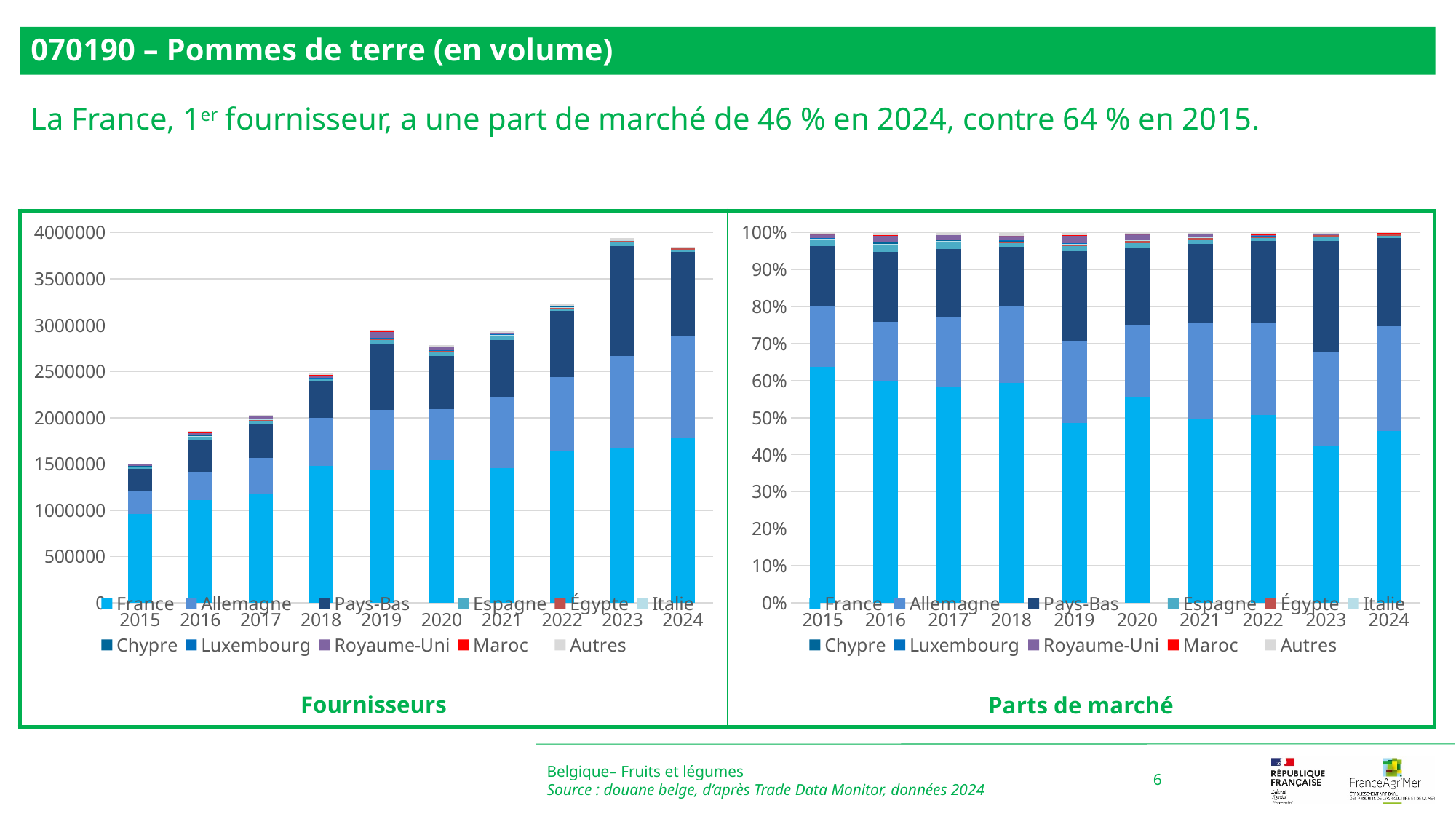
In the 'Fournisseurs' chart, is the total for 2024 greater or less than 3500000? greater In the 'Parts de marché' chart, is the share for France in 2024 greater or less than 50%? less In the 'Fournisseurs' chart, which year has the lowest total bar? 2015 How many series does the legend of the 'Fournisseurs' chart list? 11 In the 'Parts de marché' chart, is the share for France in 2015 greater or less than 60%? greater What kind of chart is the 'Fournisseurs' chart on the left? stacked bar chart In the 'Fournisseurs' chart, which year has the highest total bar? 2023 What is the title of the chart on the right of the slide? Parts de marché In the 'Fournisseurs' chart, do the total bars generally rise or fall from 2015 to 2024? rise How many years are shown on the x axis of the 'Parts de marché' chart? 10 In the 'Fournisseurs' chart, which year has the larger total bar, 2019 or 2020? 2019